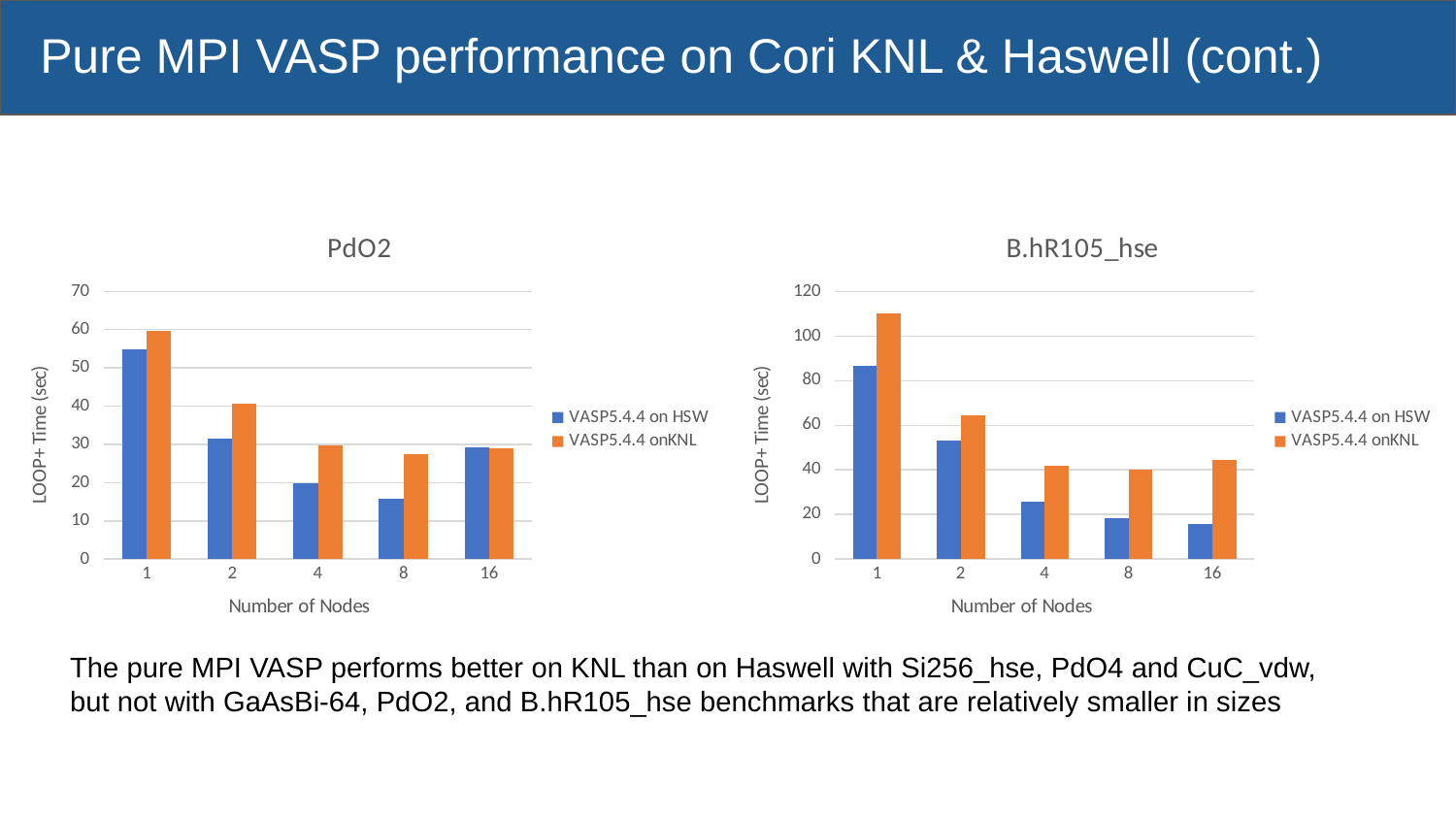
How many node counts are shown on the x axis of the PdO2 chart? 5 What kind of chart is the PdO2 chart? bar chart In the B.hR105_hse chart, is the VASP5.4.4 on HSW time at 8 nodes greater or less than 20? less In the PdO2 chart, at which number of nodes is the VASP5.4.4 on HSW time highest? 1 What is the y-axis label of the B.hR105_hse chart? LOOP+ Time (sec) In the B.hR105_hse chart, is the VASP5.4.4 onKNL time at 1 node greater or less than 100? greater In the PdO2 chart, at which number of nodes is the VASP5.4.4 on HSW time lowest? 8 In the B.hR105_hse chart, does the VASP5.4.4 on HSW time rise or fall as the number of nodes increases from 1 to 16? fall In the PdO2 chart, is the VASP5.4.4 onKNL time at 2 nodes greater or less than 30? greater In the PdO2 chart, at 4 nodes, which is larger: the VASP5.4.4 on HSW time or the VASP5.4.4 onKNL time? VASP5.4.4 onKNL How many series does the legend of the PdO2 chart list? 2 In the B.hR105_hse chart, at which number of nodes is the VASP5.4.4 onKNL time highest? 1